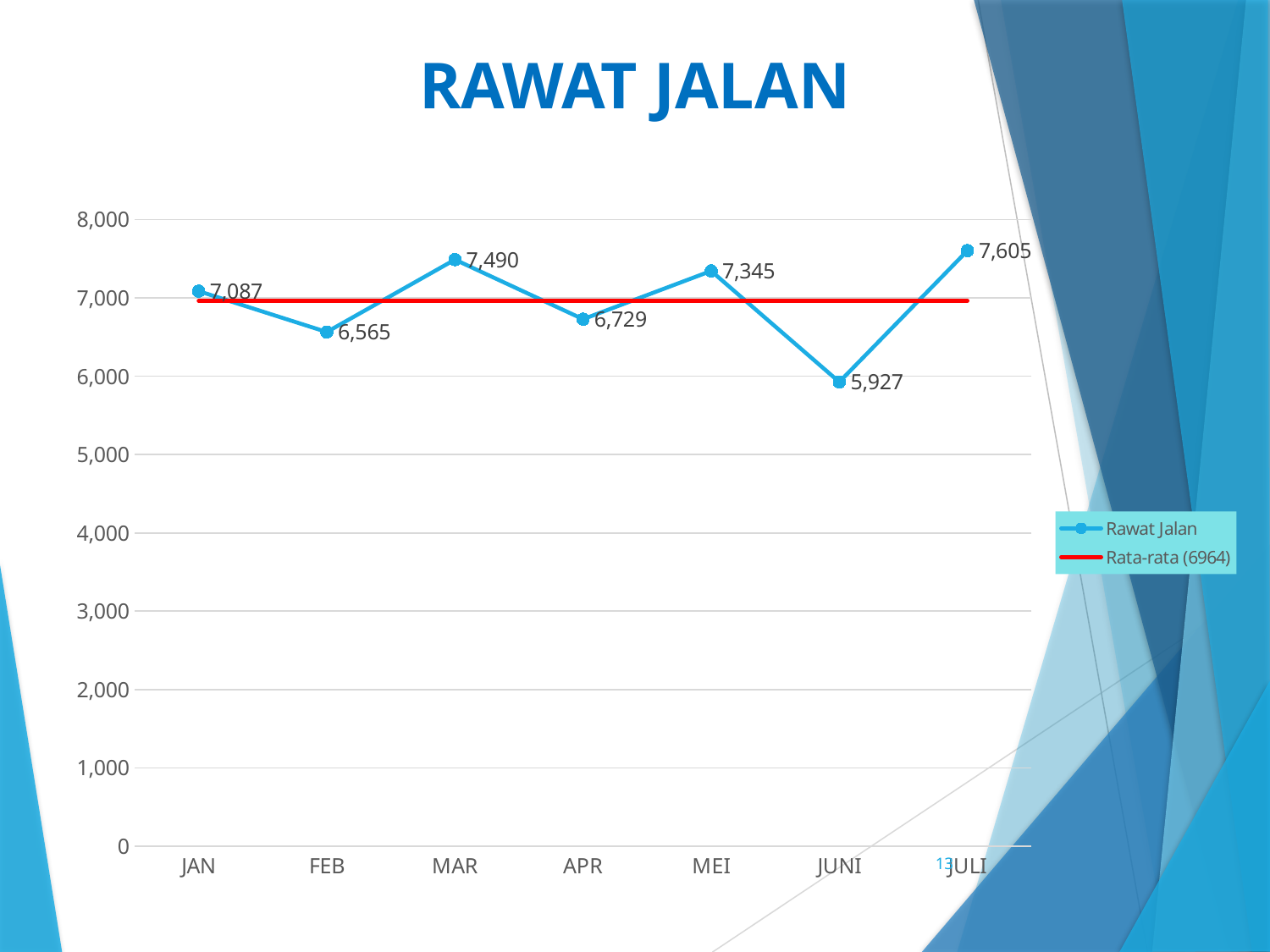
What is the Rawat Jalan value for FEB? 6,565 How many months are plotted on the x axis? 7 What kind of chart is shown on the slide? line chart Which is larger, the Rawat Jalan value for JAN or for APR? JAN Which month has the lowest Rawat Jalan value? JUNI Which month has the highest Rawat Jalan value? JULI What is the Rawat Jalan value for JUNI? 5,927 What is the difference between the Rawat Jalan values for JULI and JUNI? 1,678 What is the Rawat Jalan value for MAR? 7,490 What average value is given in the legend for the Rata-rata line? 6964 How many series does the legend list? 2 Is the Rawat Jalan value for MEI greater or less than 7,000? greater